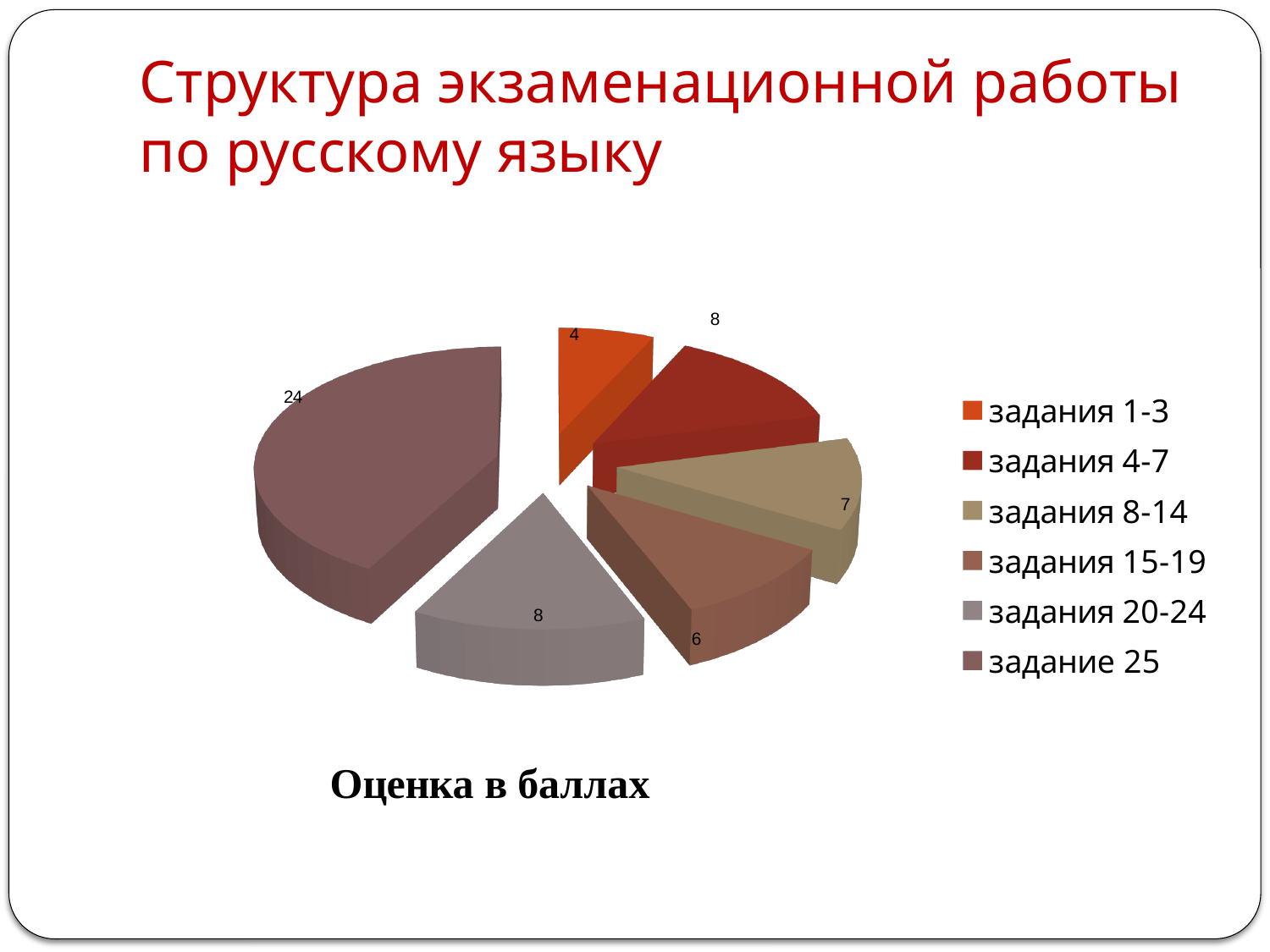
What is the value for задания 15-19? 6 Which category has the largest slice of the pie? задание 25 What type of chart is shown on the slide? pie chart Which category has the smallest slice of the pie? задания 1-3 What is the value for задания 1-3? 4 Which is larger, the value for задания 8-14 or the value for задания 15-19? задания 8-14 What is the difference between the values for задание 25 and задания 4-7? 16 What is the value for задания 8-14? 7 What is the value for задание 25? 24 What is the text label shown below the pie chart? Оценка в баллах How many slices does the pie chart have? 6 What is the total of all the values shown in the pie chart? 57